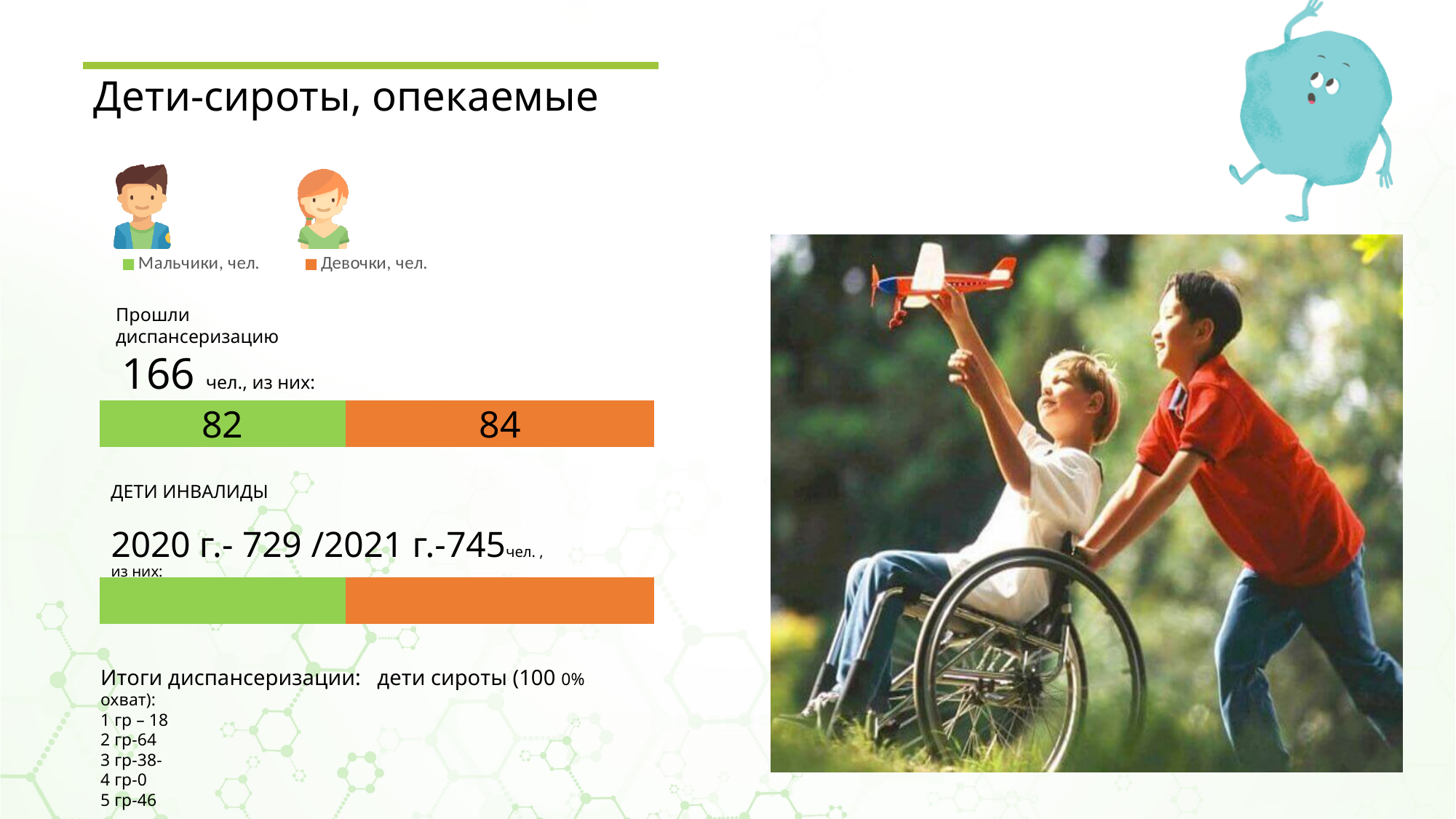
In the legend above the charts, which colour represents Девочки, чел.? Orange What kind of chart is shown under "ДЕТИ ИНВАЛИДЫ"? Bar chart In the upper bar chart under "Прошли диспансеризацию", what is the value for Девочки, чел.? 84 In the legend above the charts, which colour represents Мальчики, чел.? Green How many series does the legend above the charts list? 2 In the upper bar chart under "Прошли диспансеризацию", what is the value for Мальчики, чел.? 82 In the upper bar chart under "Прошли диспансеризацию", what is the total of the stacked bar? 166 In the upper bar chart under "Прошли диспансеризацию", which series has the smallest value? Мальчики, чел. In the upper bar chart under "Прошли диспансеризацию", which series has the larger value, Мальчики or Девочки? Девочки What kind of chart is shown under "Прошли диспансеризацию"? Bar chart In the upper bar chart under "Прошли диспансеризацию", what is the difference between the values for Девочки and Мальчики? 2